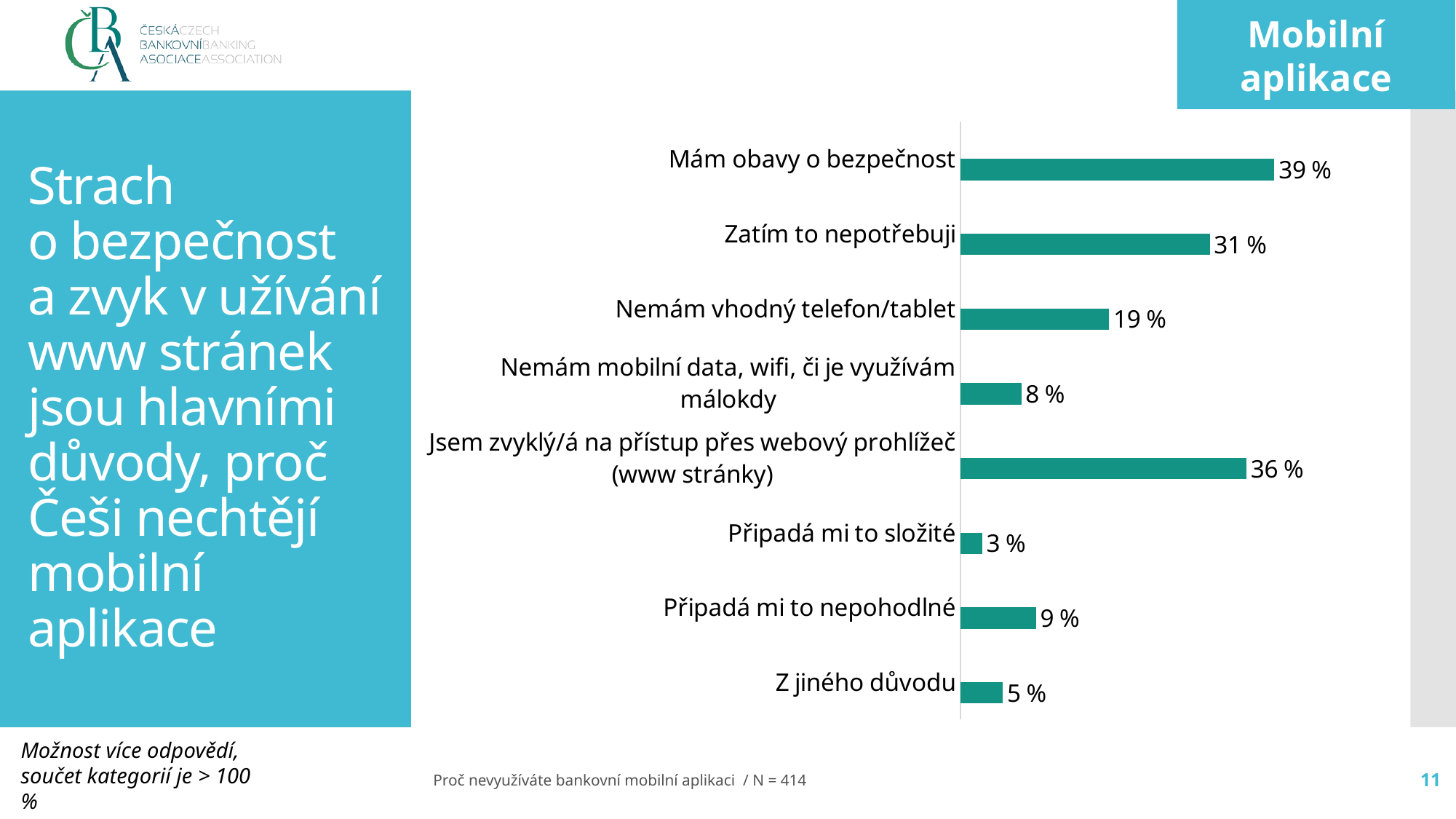
What is the sample size (N) stated below the chart? 414 What is the value for "Nemám vhodný telefon/tablet"? 19 % What is the value for "Zatím to nepotřebuji"? 31 % What is the value for "Připadá mi to nepohodlné"? 9 % Which is larger: "Zatím to nepotřebuji" or "Nemám vhodný telefon/tablet"? Zatím to nepotřebuji What kind of chart is shown on the slide? Bar chart Which category has the highest value? Mám obavy o bezpečnost Which category has the lowest value? Připadá mi to složité What is the value for "Mám obavy o bezpečnost"? 39 % How many categories does the chart show? 8 What is the difference between "Mám obavy o bezpečnost" and "Jsem zvyklý/á na přístup přes webový prohlížeč (www stránky)"? 3 % What is the difference between "Připadá mi to nepohodlné" and "Z jiného důvodu"? 4 %